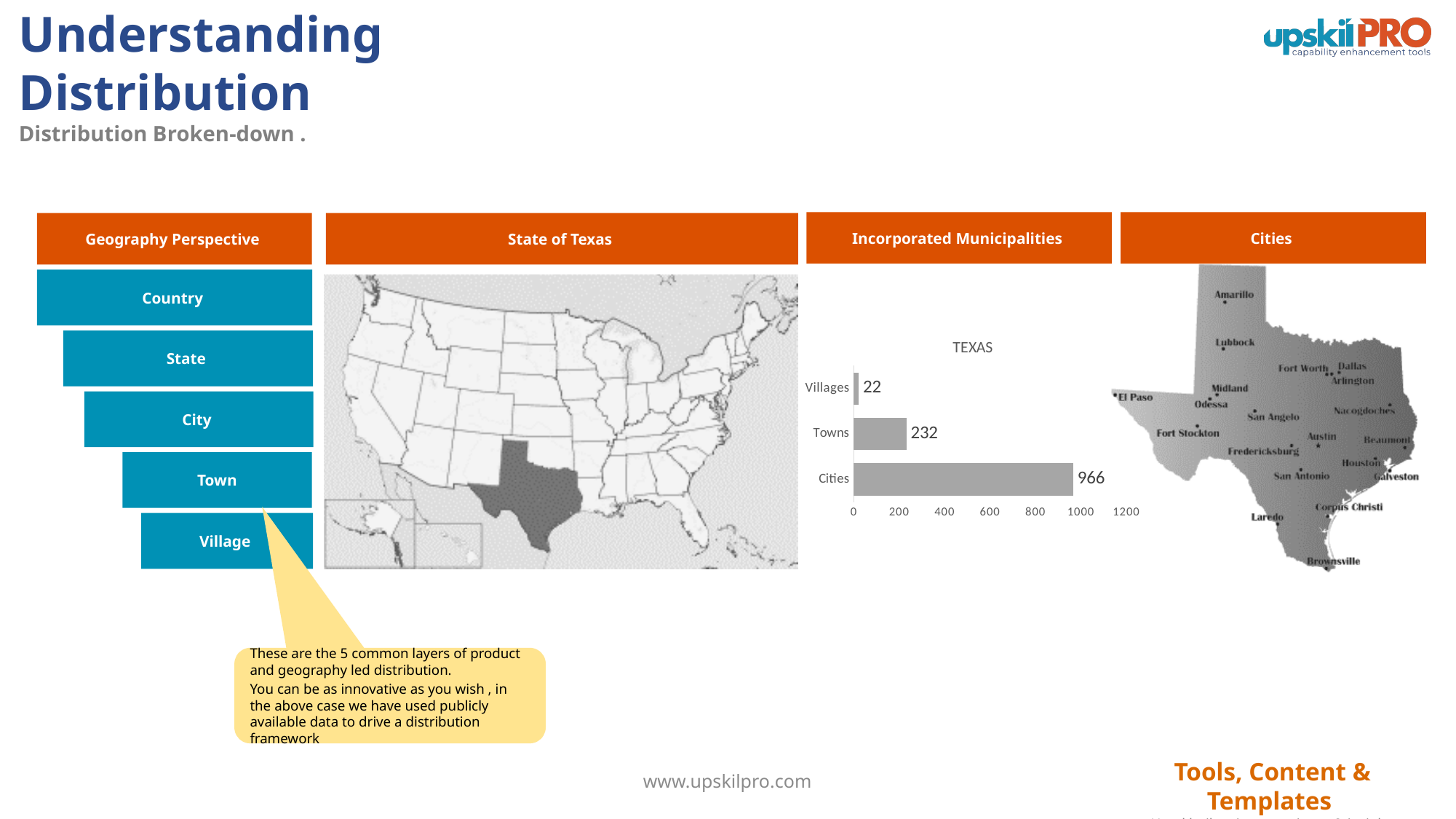
Is the value for Cities in the TEXAS chart greater or less than 800? greater Which category has the highest value in the TEXAS chart? Cities Which category has the lowest value in the TEXAS chart? Villages What kind of chart is the TEXAS chart? bar chart Which is larger in the TEXAS chart, Towns or Villages? Towns What is the title of the chart under the Incorporated Municipalities header? TEXAS What is the difference between the values for Towns and Villages in the TEXAS chart? 210 What is the value for Cities in the TEXAS chart? 966 What is the value for Villages in the TEXAS chart? 22 How many categories are shown in the TEXAS chart? 3 What is the difference between the values for Cities and Towns in the TEXAS chart? 734 What is the value for Towns in the TEXAS chart? 232